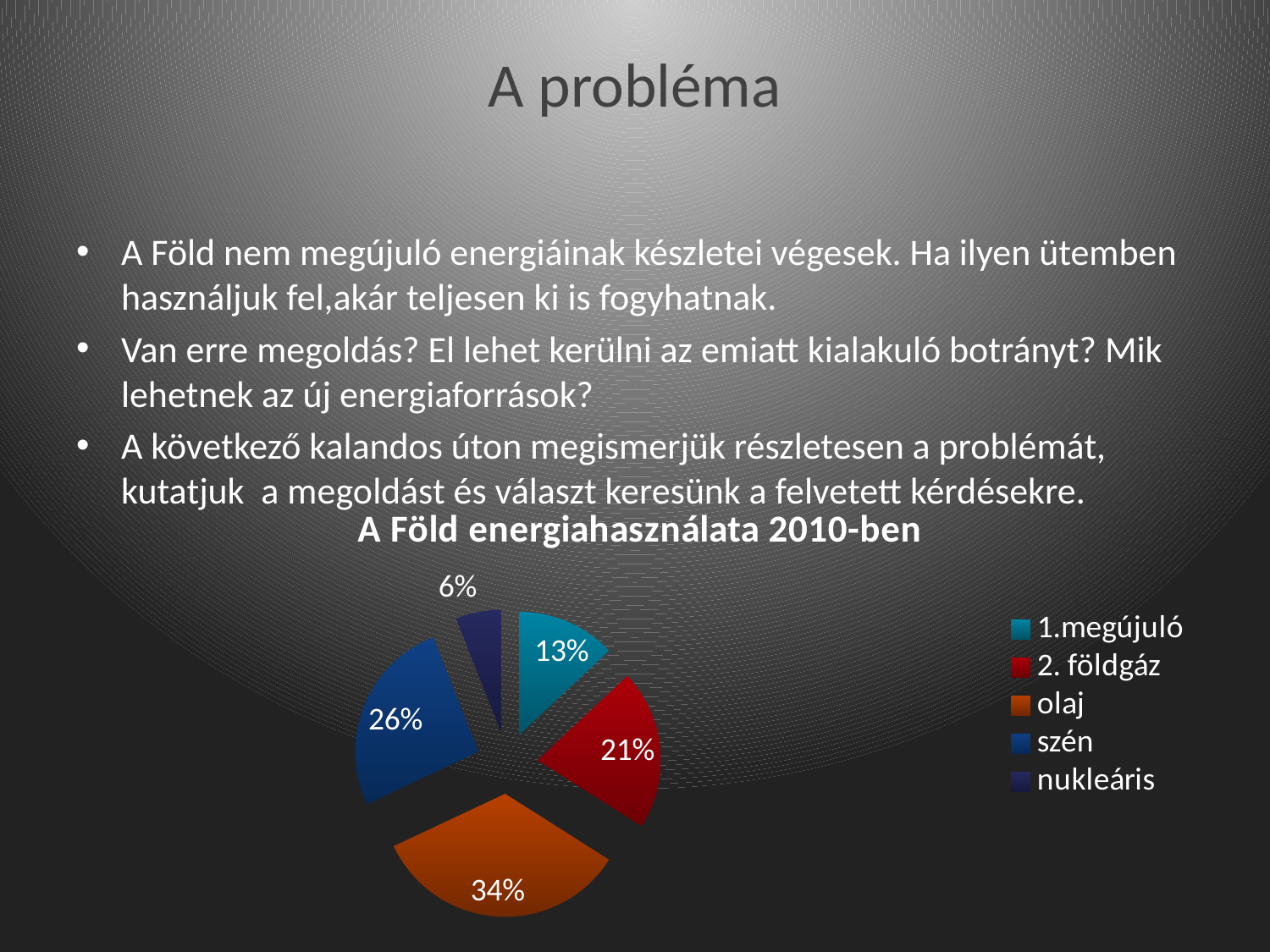
Which category has the smallest slice of the pie? nukleáris What share of the pie does olaj have? 34% Which category has the largest slice of the pie? olaj What kind of chart is shown on the slide? pie chart Which is larger, the share for 2. földgáz or the share for 1.megújuló? 2. földgáz What is the title of the chart? A Föld energiahasználata 2010-ben How many categories does the legend list? 5 What share of the pie does 1.megújuló have? 13% What share of the pie does szén have? 26% What is the difference in percentage points between olaj and szén? 8